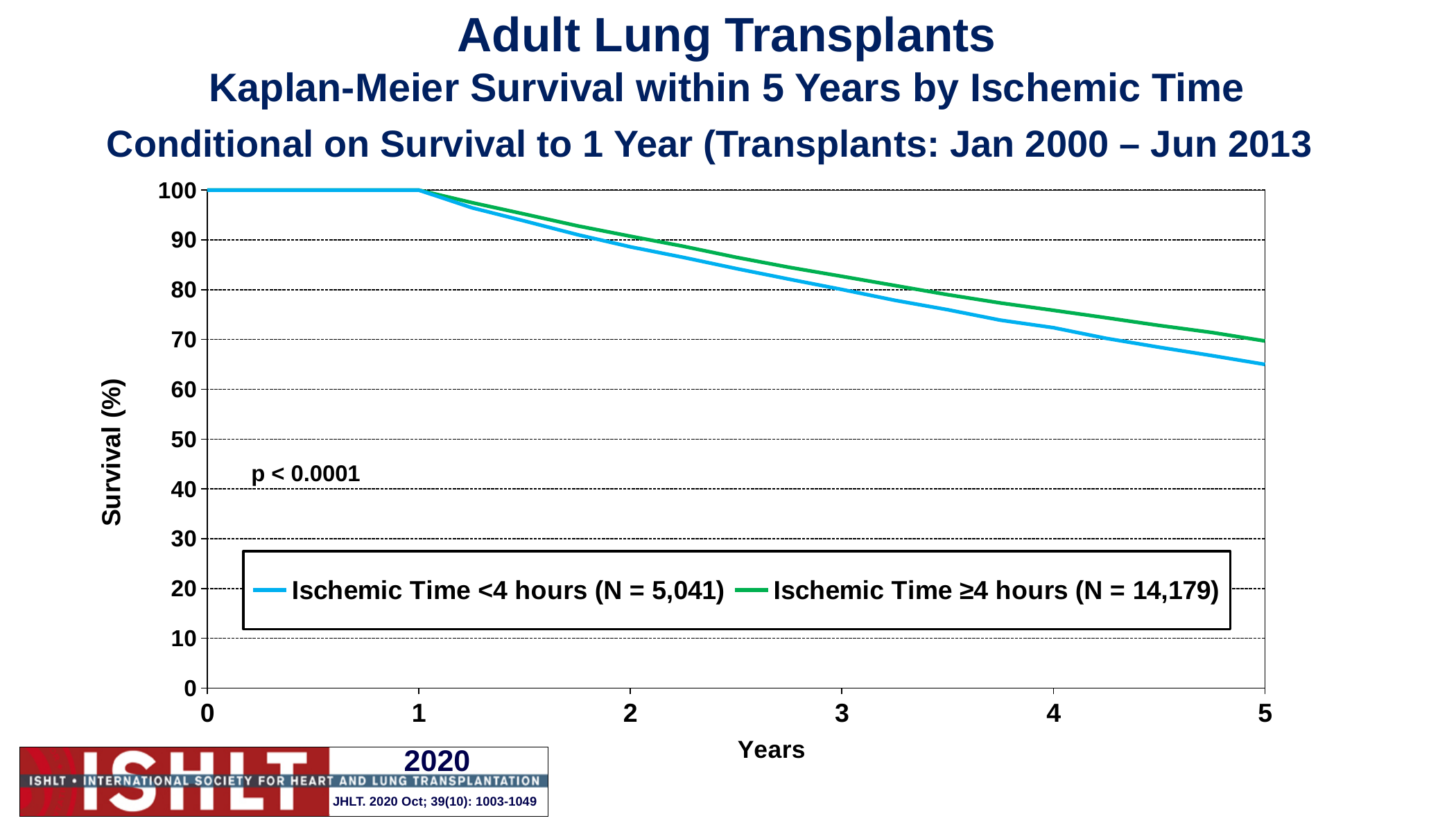
What is the survival value for Ischemic Time <4 hours at year 1? 100 Is the survival value for Ischemic Time <4 hours at year 2 greater or less than 80? greater Is the survival value for Ischemic Time ≥4 hours at year 5 greater or less than 60? greater What is the N for the Ischemic Time ≥4 hours group shown in the legend? 14,179 What p-value is printed on the chart? p < 0.0001 What is the survival value for Ischemic Time ≥4 hours at year 0? 100 Do the survival curves rise or fall from year 1 to year 5? fall How many series does the legend list? 2 At year 5, which series has the higher survival: Ischemic Time <4 hours or Ischemic Time ≥4 hours? Ischemic Time ≥4 hours What kind of chart is shown on the slide? line chart Is the survival value for Ischemic Time ≥4 hours at year 4 greater or less than 80? less